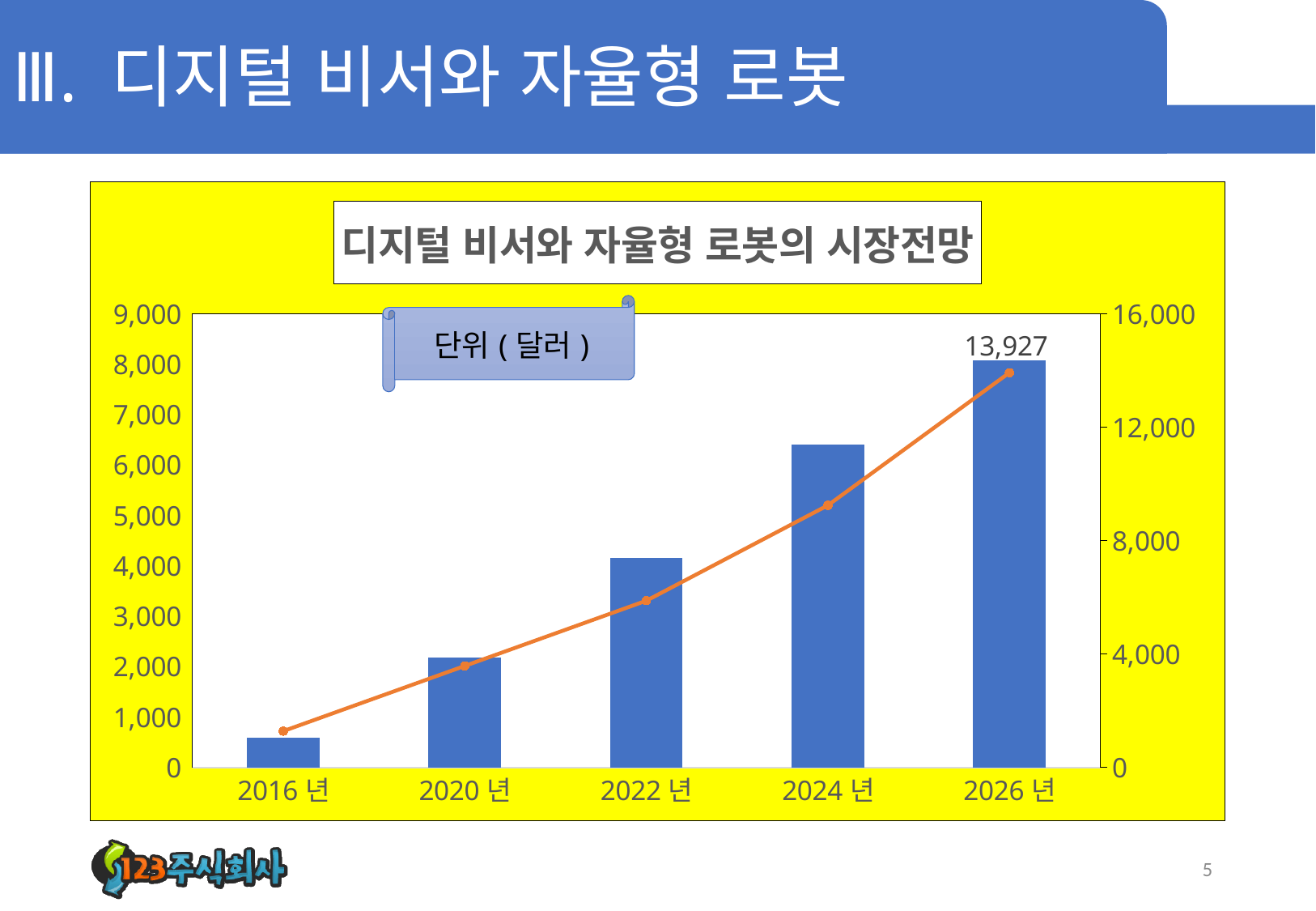
Do the bar values rise or fall from 2016 년 to 2026 년? rise How many years are shown on the x axis? 5 On the left axis, is the bar for 2016 년 greater or less than 1,000? less What is the title of the chart? 디지털 비서와 자율형 로봇의 시장전망 On the left axis, is the bar for 2024 년 greater or less than 6,000? greater What kind of chart is shown? combined bar and line chart What unit is stated in the label box on the chart? 달러 Which year has the tallest bar? 2026 년 Which year has the shortest bar? 2016 년 Which bar is taller, 2022 년 or 2024 년? 2024 년 On the left axis, is the bar for 2020 년 greater or less than 3,000? less What is the data label shown on the line at 2026 년? 13,927